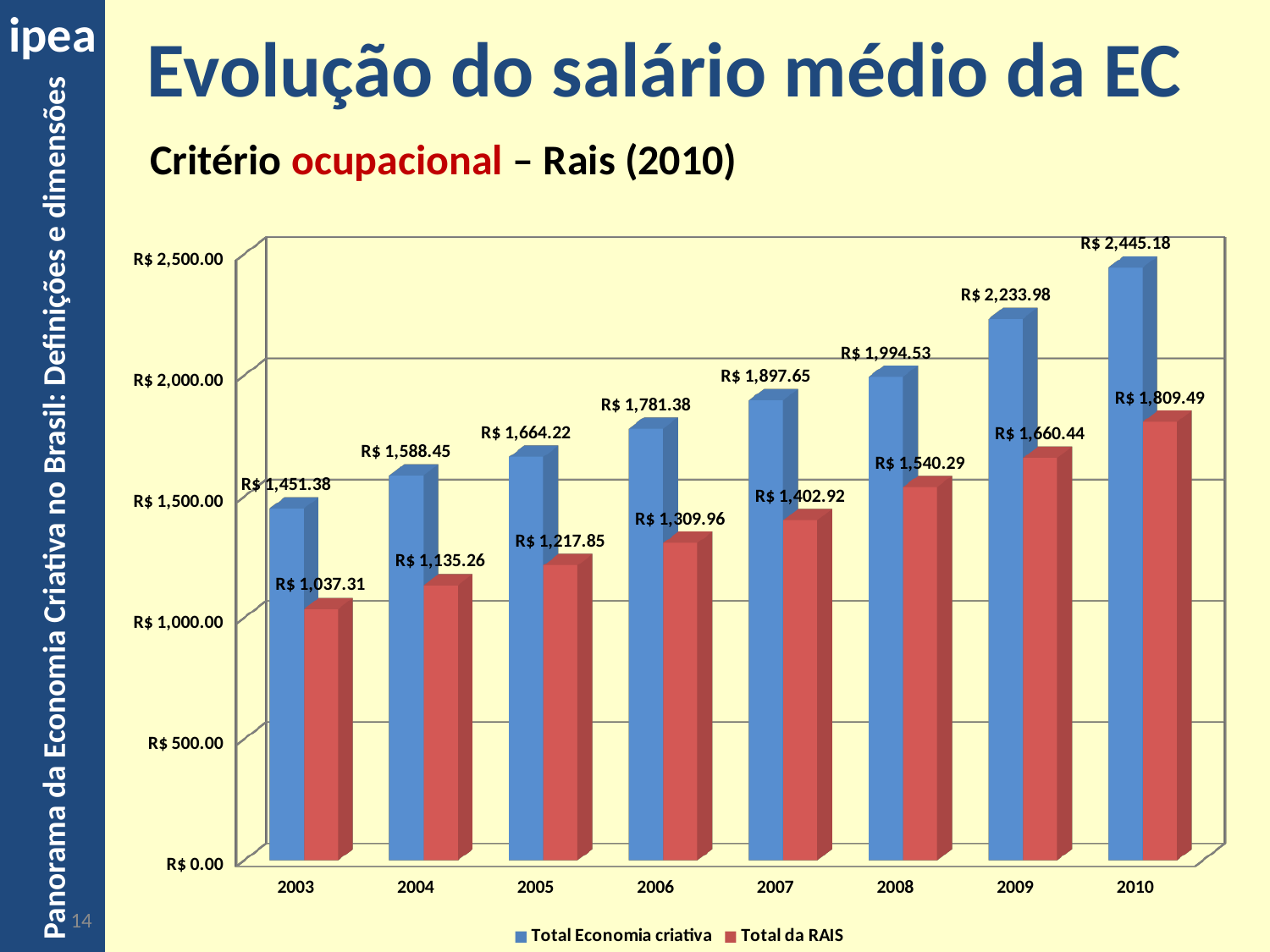
Which is larger in 2008, Total Economia criativa or Total da RAIS? Total Economia criativa How many years are shown on the x axis? 8 What is the difference between Total Economia criativa and Total da RAIS in 2010? R$ 635.69 In which year is Total da RAIS lowest? 2003 In which year is Total Economia criativa highest? 2010 What is the value for Total da RAIS in 2007? R$ 1,402.92 Do the Total da RAIS values rise or fall from 2003 to 2010? Rise What is the value for Total da RAIS in 2003? R$ 1,037.31 What is the value for Total Economia criativa in 2005? R$ 1,664.22 What is the value for Total Economia criativa in 2010? R$ 2,445.18 How many series does the legend list? 2 What kind of chart is shown on the slide? Bar chart